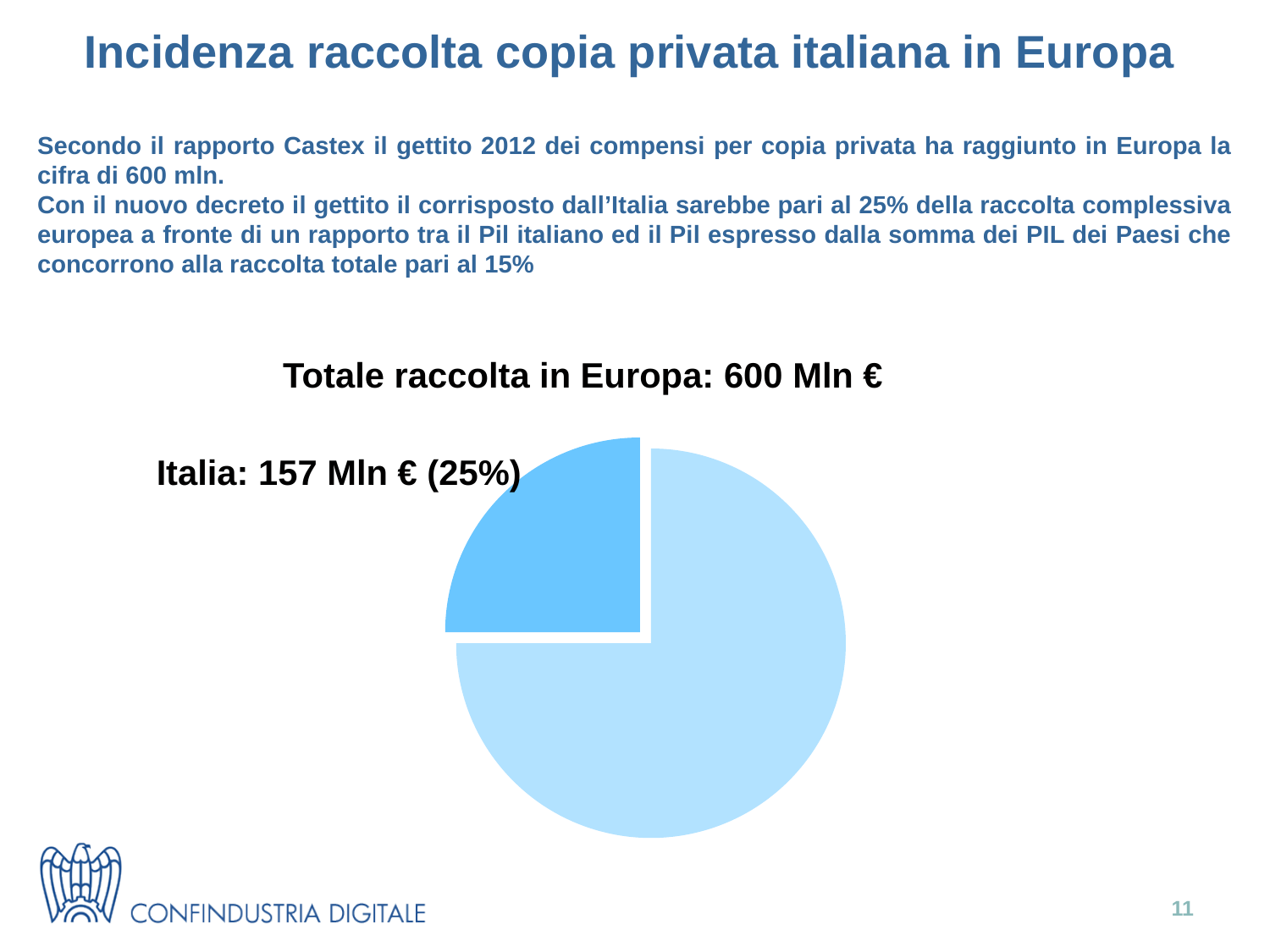
Given the total of 600 Mln € and Italia's 157 Mln €, how much does the remaining slice represent? 443 Mln € Which slice of the pie is larger: the Italia slice or the remaining (lighter) slice? the remaining (lighter) slice What is the total value represented by the pie chart, according to its title? 600 Mln € Is the Italia slice the largest or the smallest slice of the pie? smallest Is the share of the pie for Italia greater or less than 50%? less How many slices does the pie chart have? 2 What is the title of the pie chart? Totale raccolta in Europa: 600 Mln € What share of the pie does Italia represent? 25% Which slice of the pie is pulled out (exploded) from the rest of the pie? Italia What kind of chart is shown on the slide? pie chart What is the value shown for Italia in the pie chart? 157 Mln €